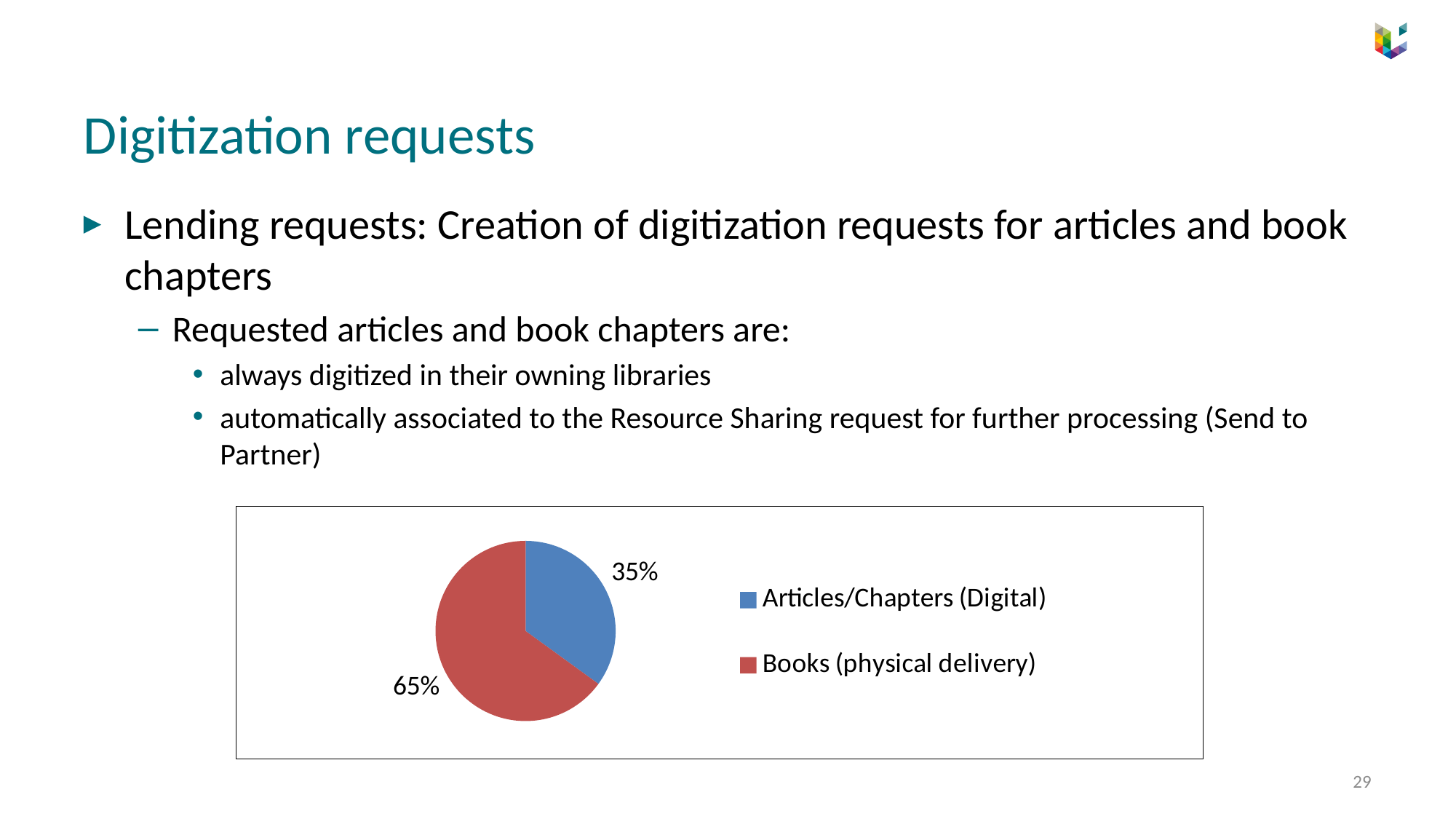
What colour is the slice for Articles/Chapters (Digital)? blue Which category has the smallest slice of the pie? Articles/Chapters (Digital) Which is larger: the share for Articles/Chapters (Digital) or the share for Books (physical delivery)? Books (physical delivery) How many slices does the pie chart have? 2 How many entries does the legend list? 2 What share of the pie is Articles/Chapters (Digital)? 35% Which category has the largest slice of the pie? Books (physical delivery) What share of the pie is Books (physical delivery)? 65% What is the difference in percentage points between Books (physical delivery) and Articles/Chapters (Digital)? 30 What kind of chart is shown on the slide? pie chart What colour is the slice for Books (physical delivery)? red